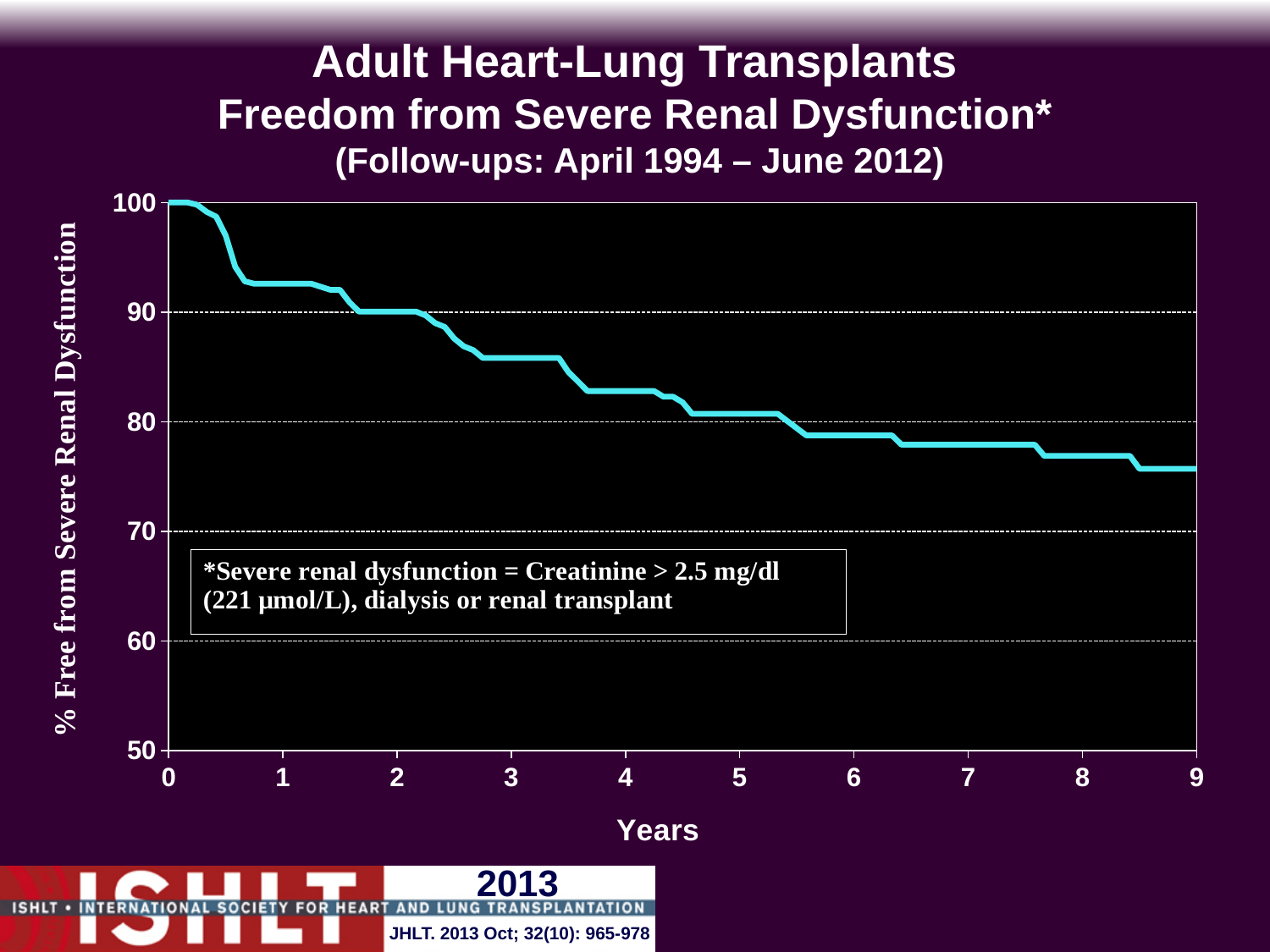
Does the curve rise or fall as the years increase? fall At which year is the curve at its lowest value? 9 What is the value of the curve at year 0? 100 Is the value of the curve at year 9 greater or less than 70? greater At which year is the curve at its highest value? 0 Is the value of the curve at year 3 greater or less than 90? less Is the value of the curve at year 6 greater or less than 80? less What is the title of the chart? Adult Heart-Lung Transplants Freedom from Severe Renal Dysfunction* (Follow-ups: April 1994 – June 2012) What kind of chart is shown on the slide? line chart What is the label of the x axis? Years